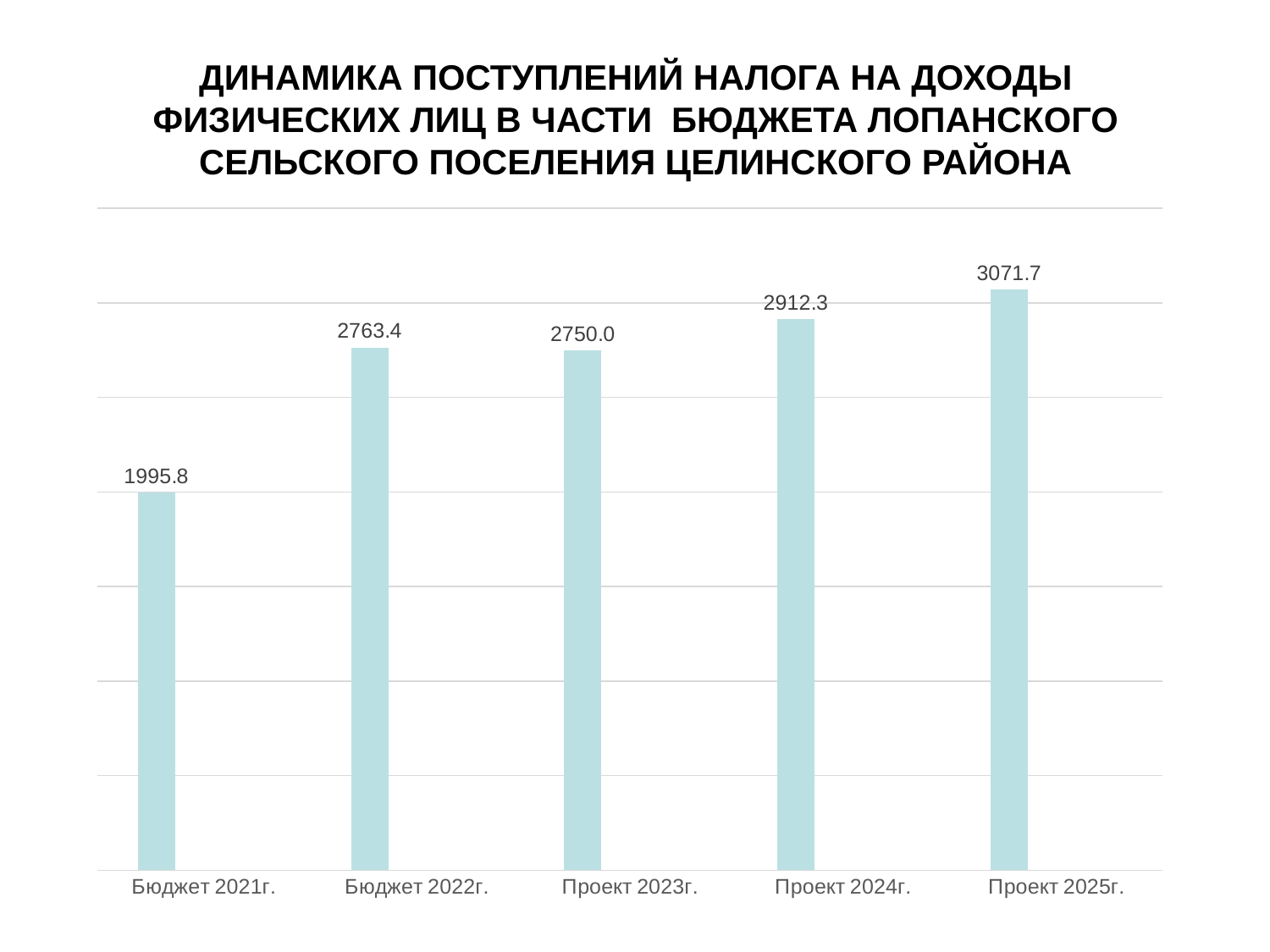
Which is larger, the value for Проект 2024г. or the value for Бюджет 2021г.? Проект 2024г. Which category has the highest value? Проект 2025г. How many categories are shown on the chart? 5 What kind of chart is shown on the slide? bar chart What is the value for Проект 2024г.? 2912.3 What is the value for Бюджет 2021г.? 1995.8 Which is larger, the value for Бюджет 2022г. or the value for Проект 2023г.? Бюджет 2022г. What is the value for Проект 2023г.? 2750.0 What is the difference between the values for Проект 2025г. and Бюджет 2021г.? 1075.9 What colour are the bars on the chart? light blue Which category has the lowest value? Бюджет 2021г. What is the difference between the values for Проект 2024г. and Проект 2023г.? 162.3